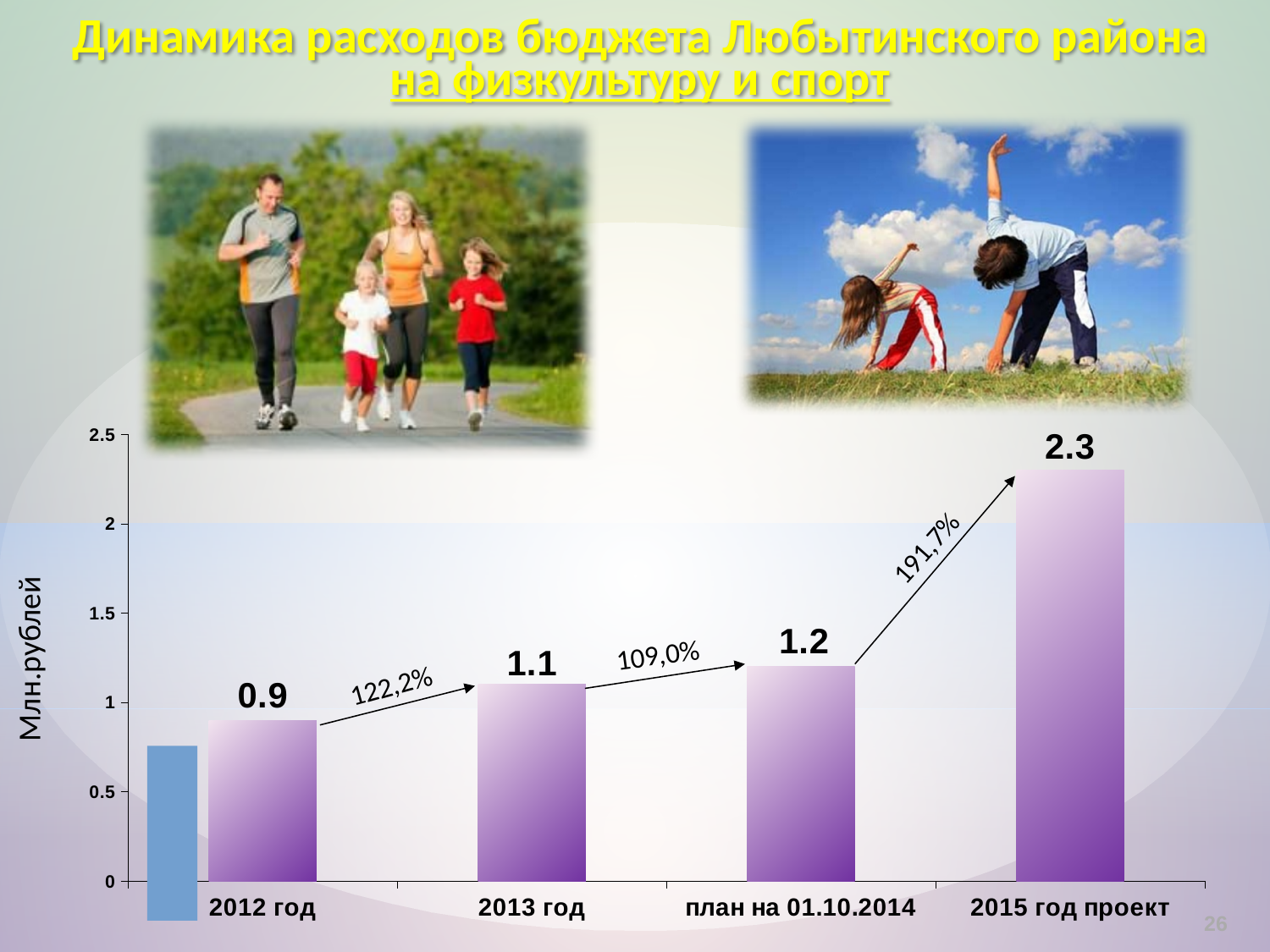
What is the value for 2012 год? 0.9 Which labelled category has the lowest value? 2012 год What is the value for 2015 год проект? 2.3 What kind of chart is shown on the slide? bar chart What is the value for 2013 год? 1.1 Is the value for 2015 год проект greater or less than 2? greater Which is larger, the value for 2013 год or the value for 2015 год проект? 2015 год проект What is the value for план на 01.10.2014? 1.2 Which labelled category has the highest value? 2015 год проект Do the values rise or fall from 2012 год to 2015 год проект? rise What is the difference between the values for 2013 год and 2012 год? 0.2 What is the difference between the values for 2015 год проект and план на 01.10.2014? 1.1